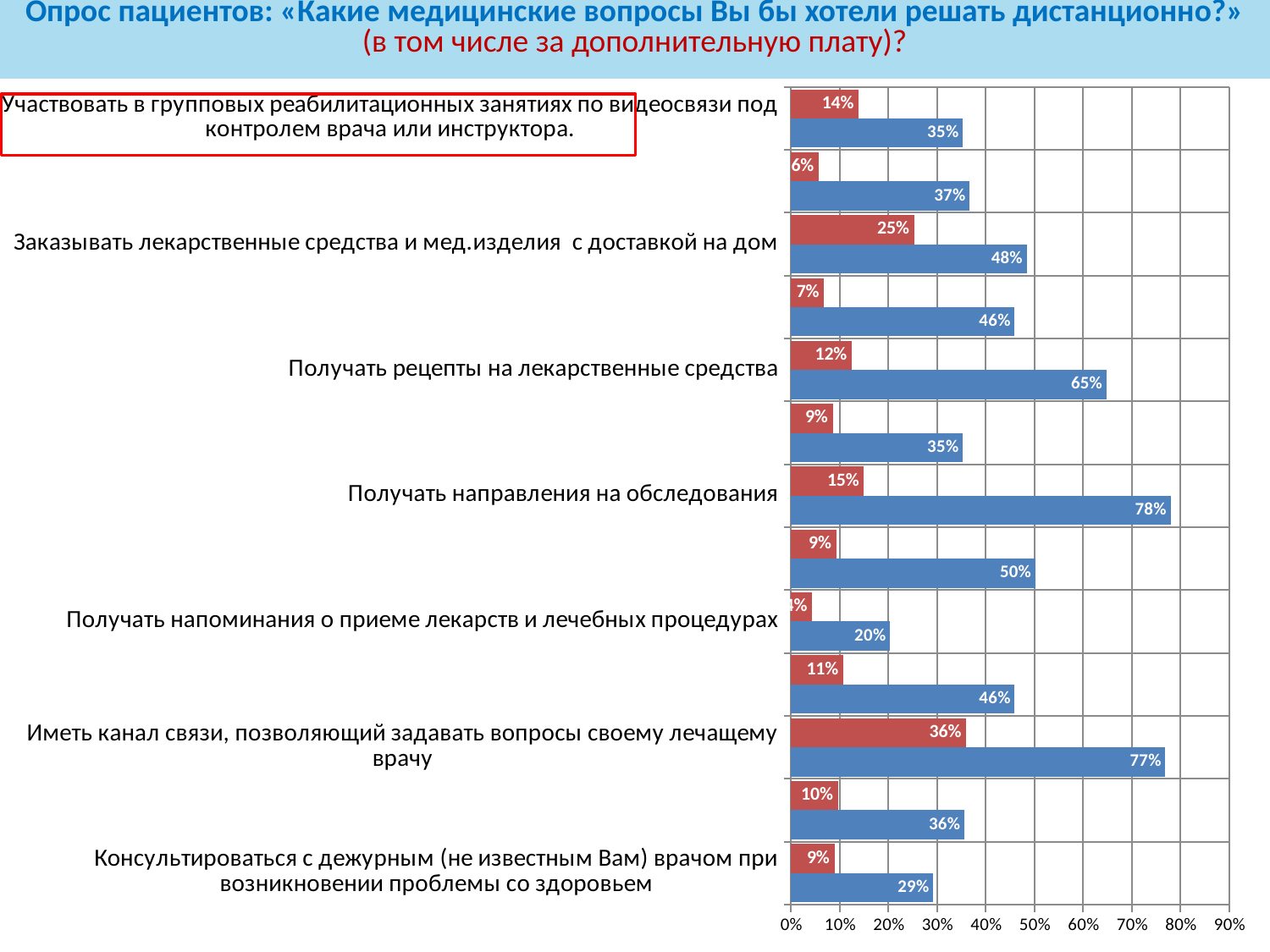
What is the value of the blue bar for "Получать рецепты на лекарственные средства"? 65% What is the value of the red bar for "Заказывать лекарственные средства и мед.изделия с доставкой на дом"? 25% What is the value of the red bar for "Иметь канал связи, позволяющий задавать вопросы своему лечащему врачу"? 36% Which labelled category has the highest blue bar value? Получать направления на обследования What is the value of the blue bar for "Консультироваться с дежурным (не известным Вам) врачом при возникновении проблемы со здоровьем"? 29% Which labelled category has the lowest red bar value? Получать напоминания о приеме лекарств и лечебных процедурах What type of chart is shown on the slide? bar chart What is the value of the blue bar for "Получать направления на обследования"? 78% What is the difference between the blue and red bar values for "Иметь канал связи, позволяющий задавать вопросы своему лечащему врачу"? 41% What is the difference between the blue bar values for "Получать направления на обследования" and "Участвовать в групповых реабилитационных занятиях по видеосвязи под контролем врача или инструктора"? 43% Is the blue bar value for "Получать напоминания о приеме лекарств и лечебных процедурах" greater or less than 30%? less Which is larger: the blue bar for "Получать рецепты на лекарственные средства" or the blue bar for "Заказывать лекарственные средства и мед.изделия с доставкой на дом"? Получать рецепты на лекарственные средства